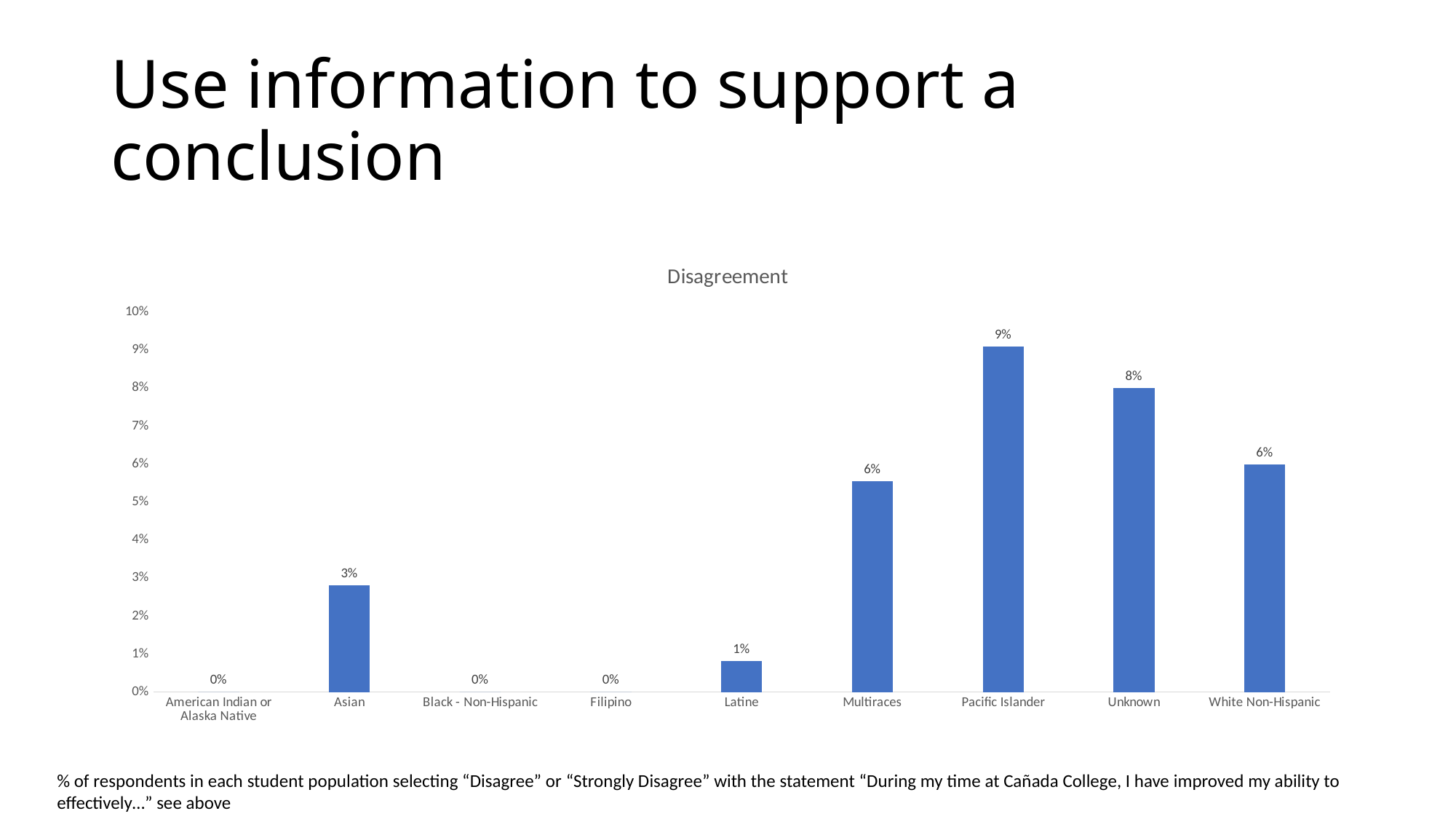
Which category has the highest value? Pacific Islander What is the value for Pacific Islander? 9% What is the value for Latine? 1% What is the value for Asian? 3% Which is larger, the value for Multiraces or the value for Asian? Multiraces How many categories are shown on the x axis? 9 Is the value for White Non-Hispanic greater or less than 5%? greater How many categories have a value of 0%? 3 What kind of chart is shown? bar chart What is the title of the chart? Disagreement What is the value for Unknown? 8% What is the difference between the values for Pacific Islander and Unknown? 1%